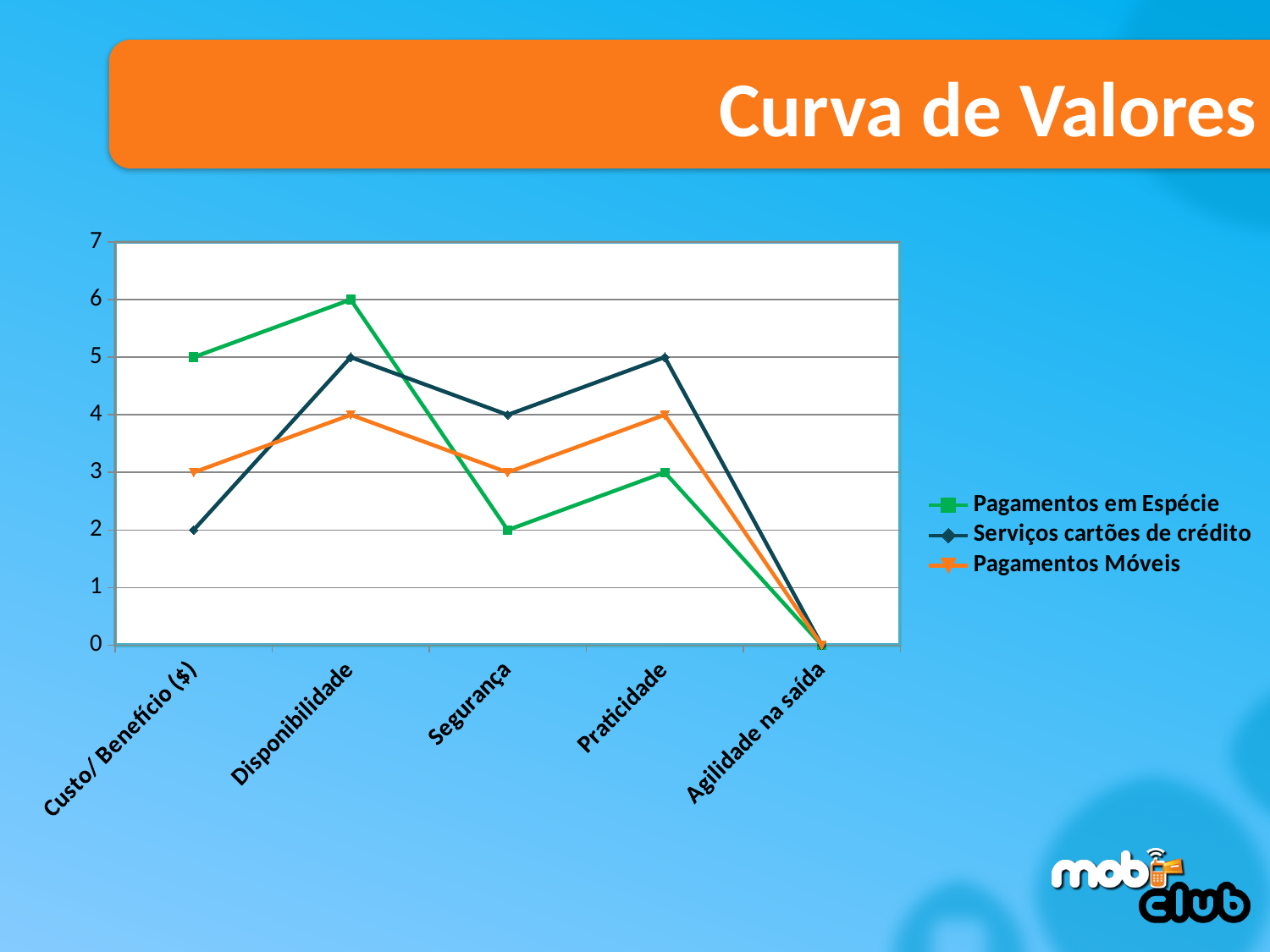
What kind of chart is shown on the slide? line chart How many categories are shown on the x axis? 5 What is the value for Serviços cartões de crédito at Segurança? 4 At which category do all three series reach their lowest value? Agilidade na saída What is the value for Pagamentos Móveis at Custo/ Benefício ($)? 3 Does the Pagamentos em Espécie line rise or fall from Disponibilidade to Segurança? fall What is the value for Pagamentos em Espécie at Disponibilidade? 6 Which series has the higher value at Praticidade, Serviços cartões de crédito or Pagamentos em Espécie? Serviços cartões de crédito At which category does Pagamentos em Espécie reach its highest value? Disponibilidade How many series does the legend list? 3 What is the difference between Pagamentos em Espécie and Serviços cartões de crédito at Custo/ Benefício ($)? 3 What is the title of the slide containing the chart? Curva de Valores